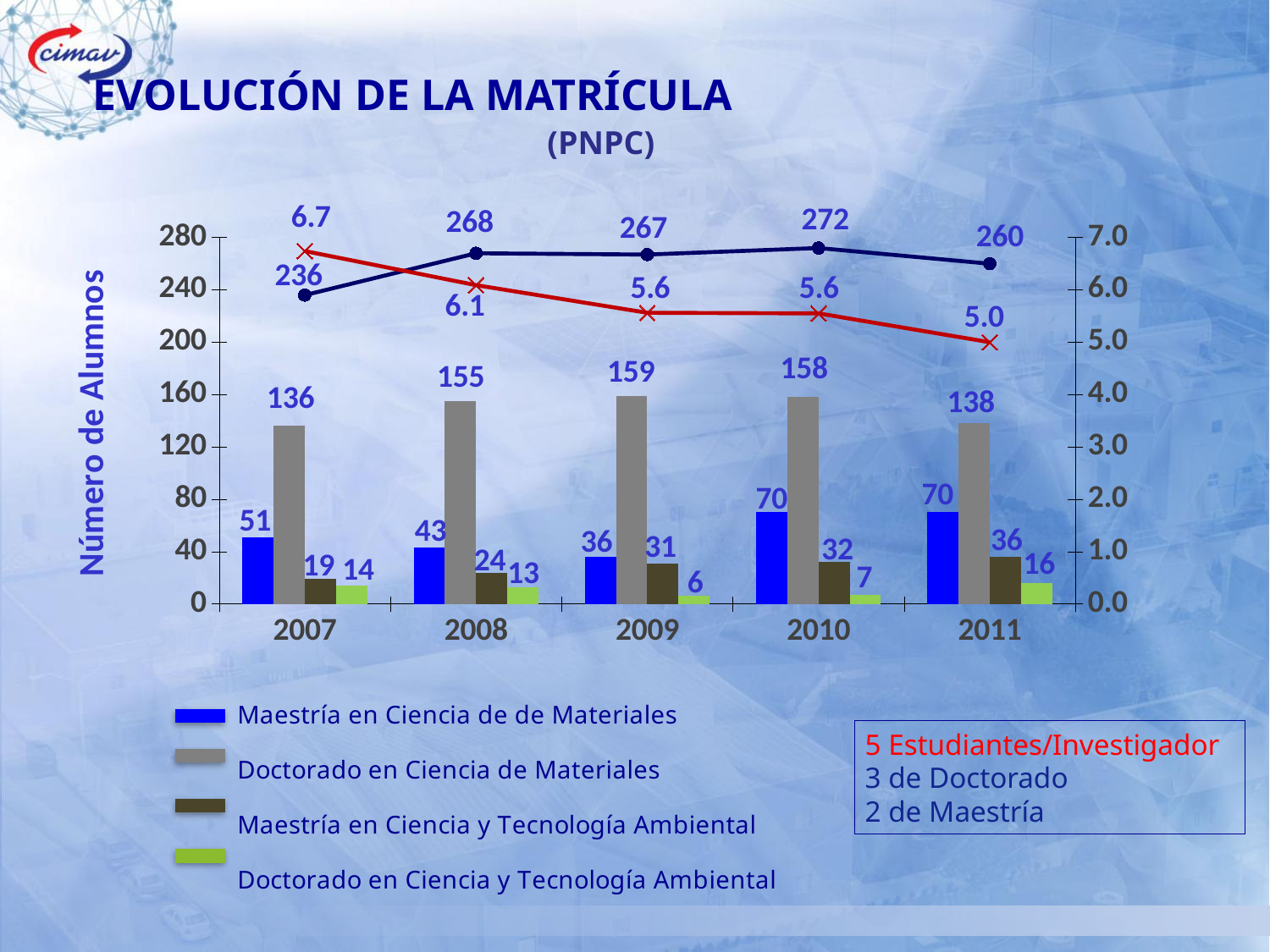
What is the value for Doctorado en Ciencia y Tecnología Ambiental in 2011? 16 How many series does the legend list? 4 In which year is Doctorado en Ciencia y Tecnología Ambiental lowest? 2009 What is the value of the red line in 2007? 6.7 What is the value for Doctorado en Ciencia de Materiales in 2009? 159 What is the value for Maestría en Ciencia de de Materiales in 2010? 70 How many years are shown on the x axis? 5 What is the difference between Doctorado en Ciencia de Materiales in 2008 and in 2011? 17 What is the value of the dark blue line in 2010? 272 Does the red line rise or fall from 2007 to 2011? fall Which is larger: Maestría en Ciencia y Tecnología Ambiental in 2007 or in 2011? 2011 In which year is Doctorado en Ciencia de Materiales highest? 2009